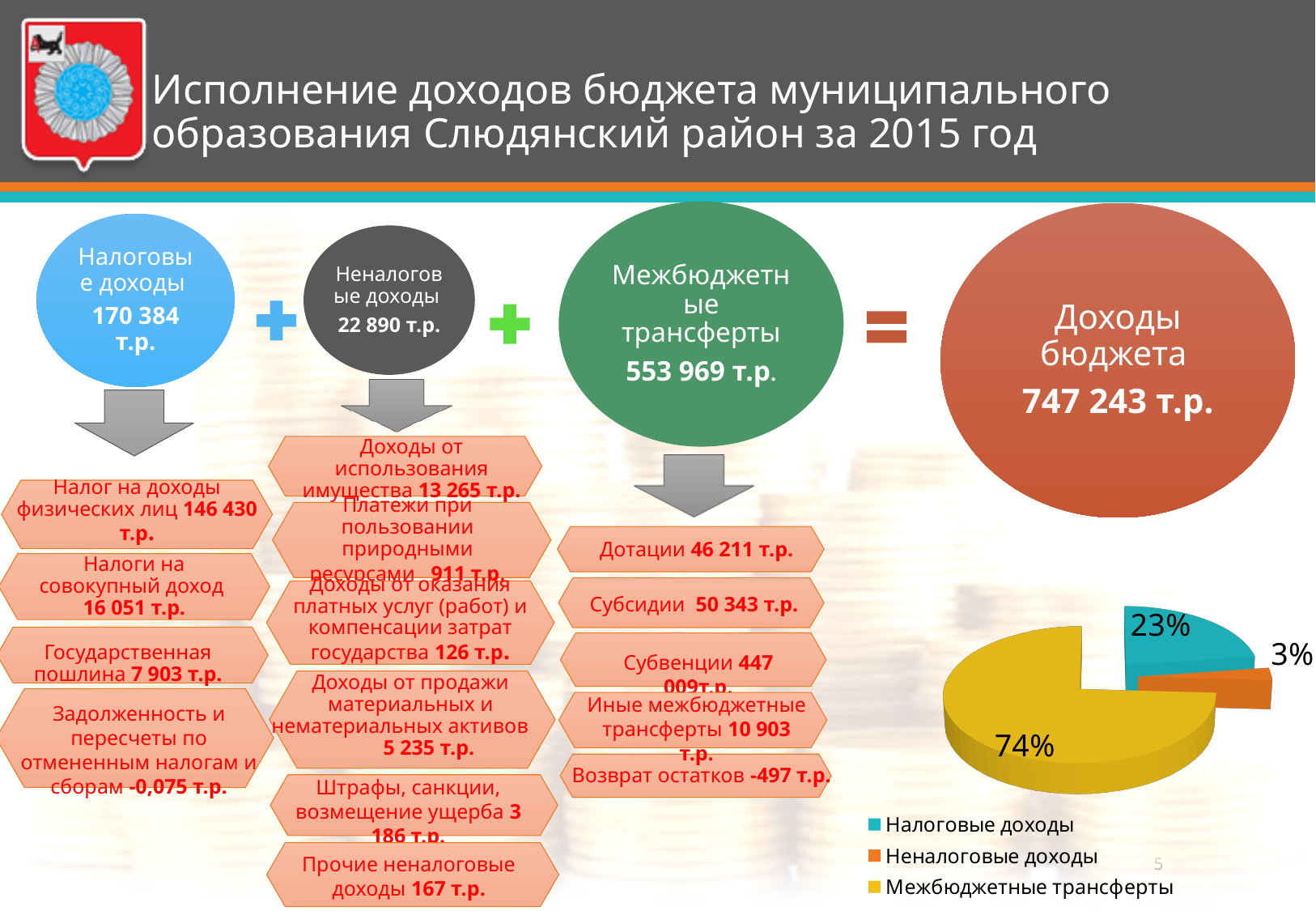
In the pie chart, what share is shown for Межбюджетные трансферты? 74% What colour is the Налоговые доходы slice in the pie chart? teal What colour is the Межбюджетные трансферты slice in the pie chart? yellow Which category has the smallest slice in the pie chart? Неналоговые доходы What kind of chart is shown on the slide? pie chart What is the difference in percentage points between the Межбюджетные трансферты slice and the Налоговые доходы slice? 51 How many entries does the pie chart legend list? 3 In the pie chart, what share is shown for Неналоговые доходы? 3% Which slice is larger in the pie chart: Налоговые доходы or Неналоговые доходы? Налоговые доходы How many slices does the pie chart have? 3 In the pie chart, what share is shown for Налоговые доходы? 23% Which category has the largest slice in the pie chart? Межбюджетные трансферты